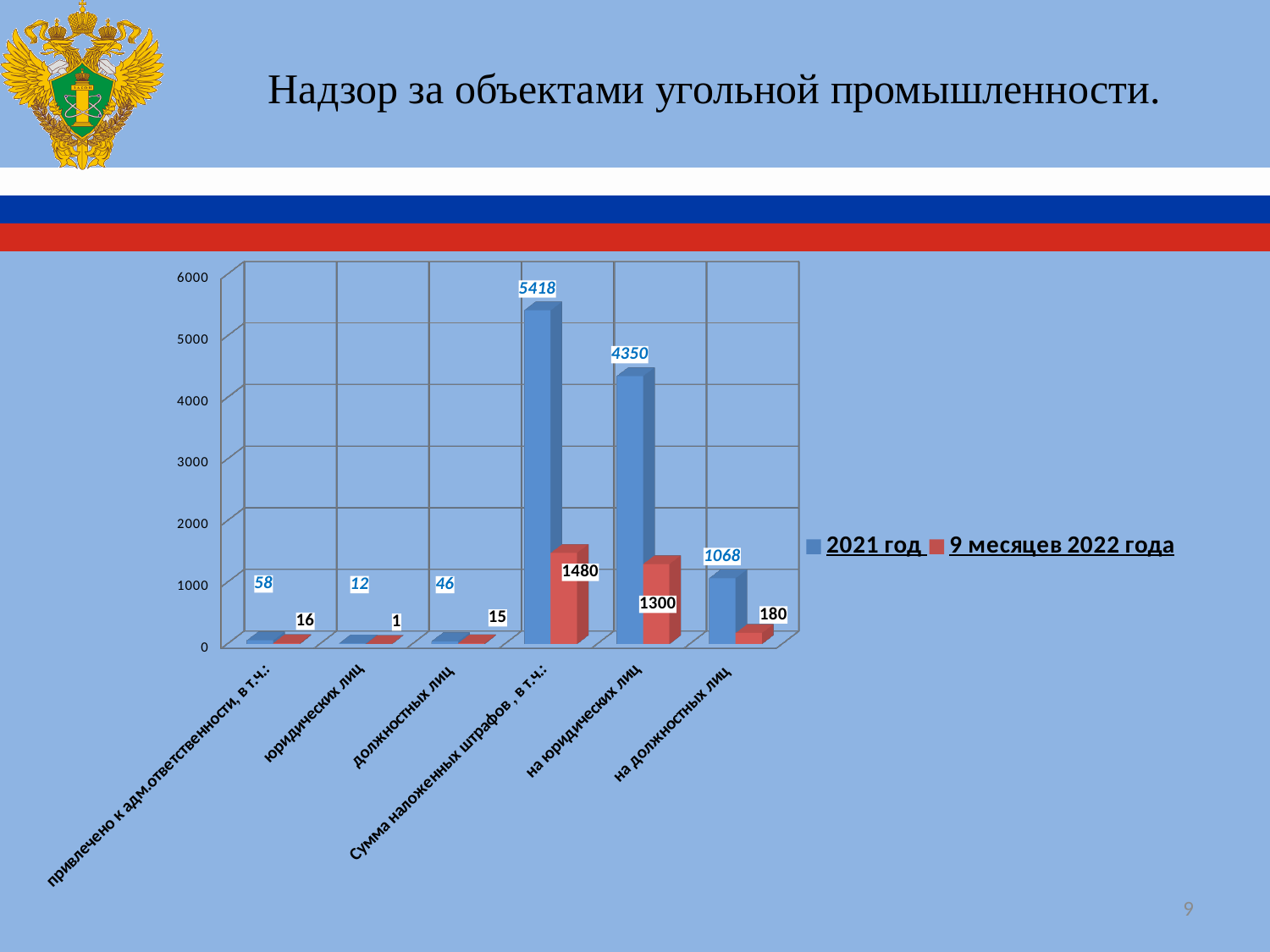
Which is larger: the "2021 год" value for "на должностных лиц" or the "9 месяцев 2022 года" value for "Сумма наложенных штрафов , в т.ч.:"? 9 месяцев 2022 года value for Сумма наложенных штрафов , в т.ч.: What is the value for "юридических лиц" in the "2021 год" series? 12 Which category has the highest value in the "2021 год" series? Сумма наложенных штрафов , в т.ч.: What is the value for "на должностных лиц" in the "9 месяцев 2022 года" series? 180 What is the difference between the "2021 год" and "9 месяцев 2022 года" values for "на юридических лиц"? 3050 What is the value for "на юридических лиц" in the "9 месяцев 2022 года" series? 1300 What kind of chart is shown on the slide? bar chart Is the "2021 год" value for "на юридических лиц" greater or less than 4000? greater What is the value for "Сумма наложенных штрафов , в т.ч.:" in the "2021 год" series? 5418 How many series does the legend list? 2 Which category has the lowest value in the "9 месяцев 2022 года" series? юридических лиц How many categories are shown on the x axis? 6